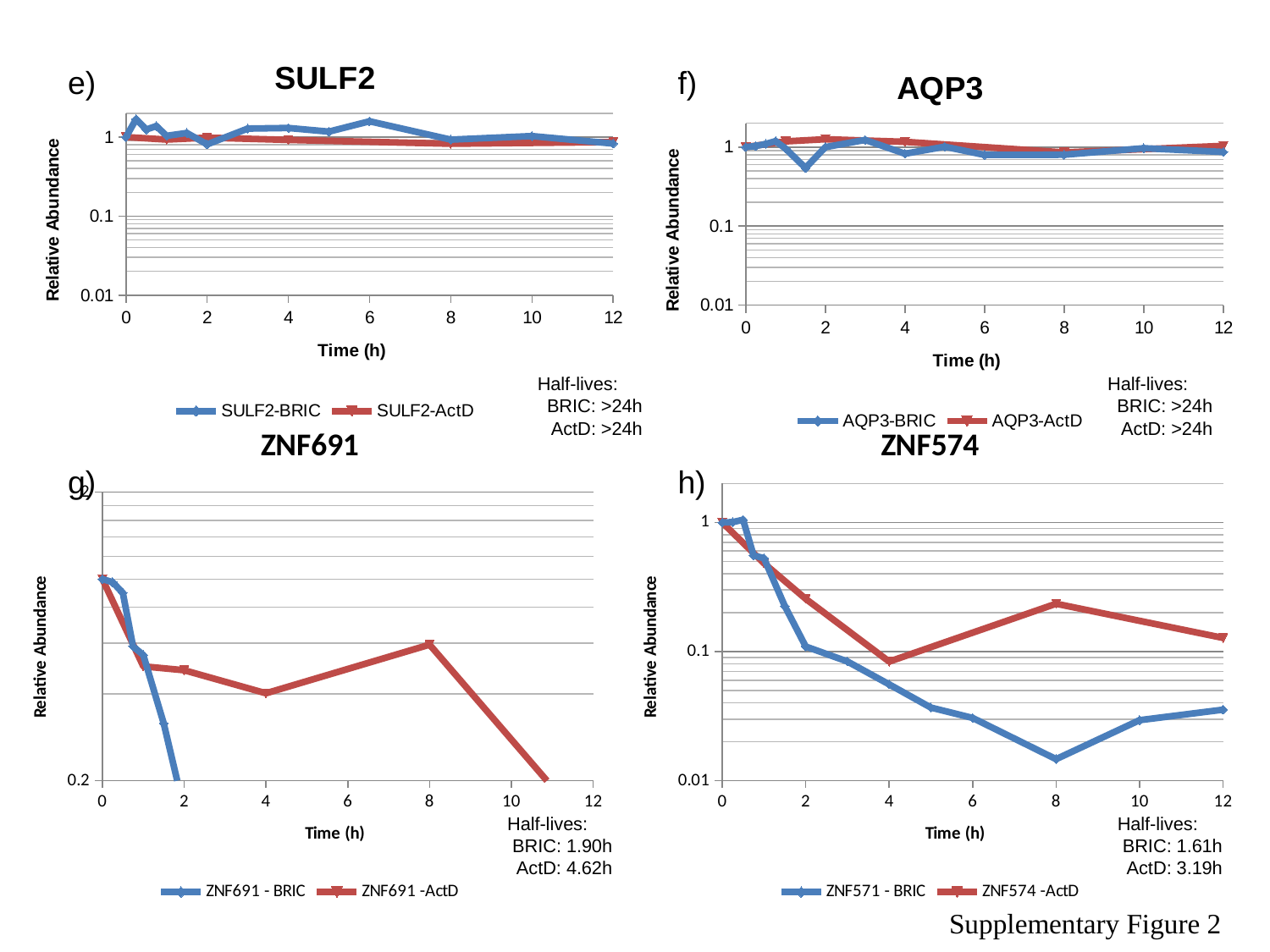
In the ZNF574 chart, is the value of the ActD series at 8 h greater or less than 0.1? greater In the ZNF574 chart, which series has the larger value at 8 h, BRIC or ActD? ActD In the AQP3 chart, is the value of the BRIC series at 1.5 h greater or less than 1? less In the ZNF574 chart, what are the two series named in the legend? ZNF571 - BRIC and ZNF574 -ActD What is the x-axis label of the ZNF691 chart? Time (h) How many series does the legend of the AQP3 chart list? 2 In the ZNF691 chart, is the value of the ActD series at 8 h greater or less than 0.2? greater In the ZNF574 chart, does the BRIC series generally rise or fall between 0 h and 8 h? fall What kind of chart is the SULF2 chart? line chart How many charts are shown on the slide? 4